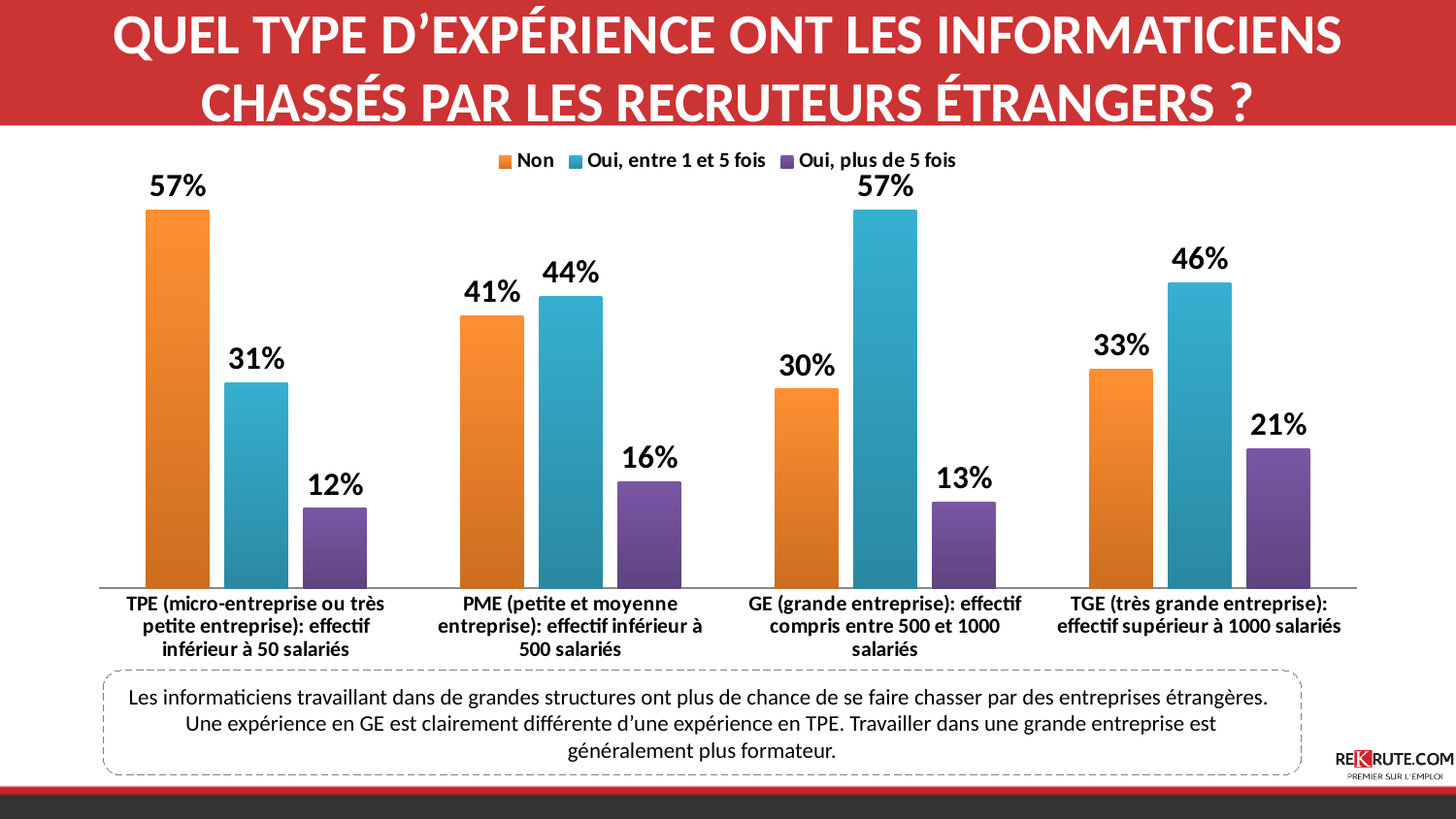
What is the value of the "Oui, entre 1 et 5 fois" series for PME (petite et moyenne entreprise)? 44% Which category has the highest value for the "Oui, plus de 5 fois" series? TGE (très grande entreprise) Which category has the lowest value for the "Non" series? GE (grande entreprise) What is the difference between the "Non" value and the "Oui, entre 1 et 5 fois" value for TPE? 26% What kind of chart is shown on the slide? Bar chart What is the value of the "Oui, entre 1 et 5 fois" series for GE (grande entreprise)? 57% What is the value of the "Oui, plus de 5 fois" series for TGE (très grande entreprise)? 21% How many series does the legend list? 3 For PME, which is larger: the "Non" value or the "Oui, entre 1 et 5 fois" value? Oui, entre 1 et 5 fois Which legend entry is shown in orange? Non What is the value of the "Non" series for TPE (micro-entreprise ou très petite entreprise)? 57% How many company-size categories are shown on the x axis? 4